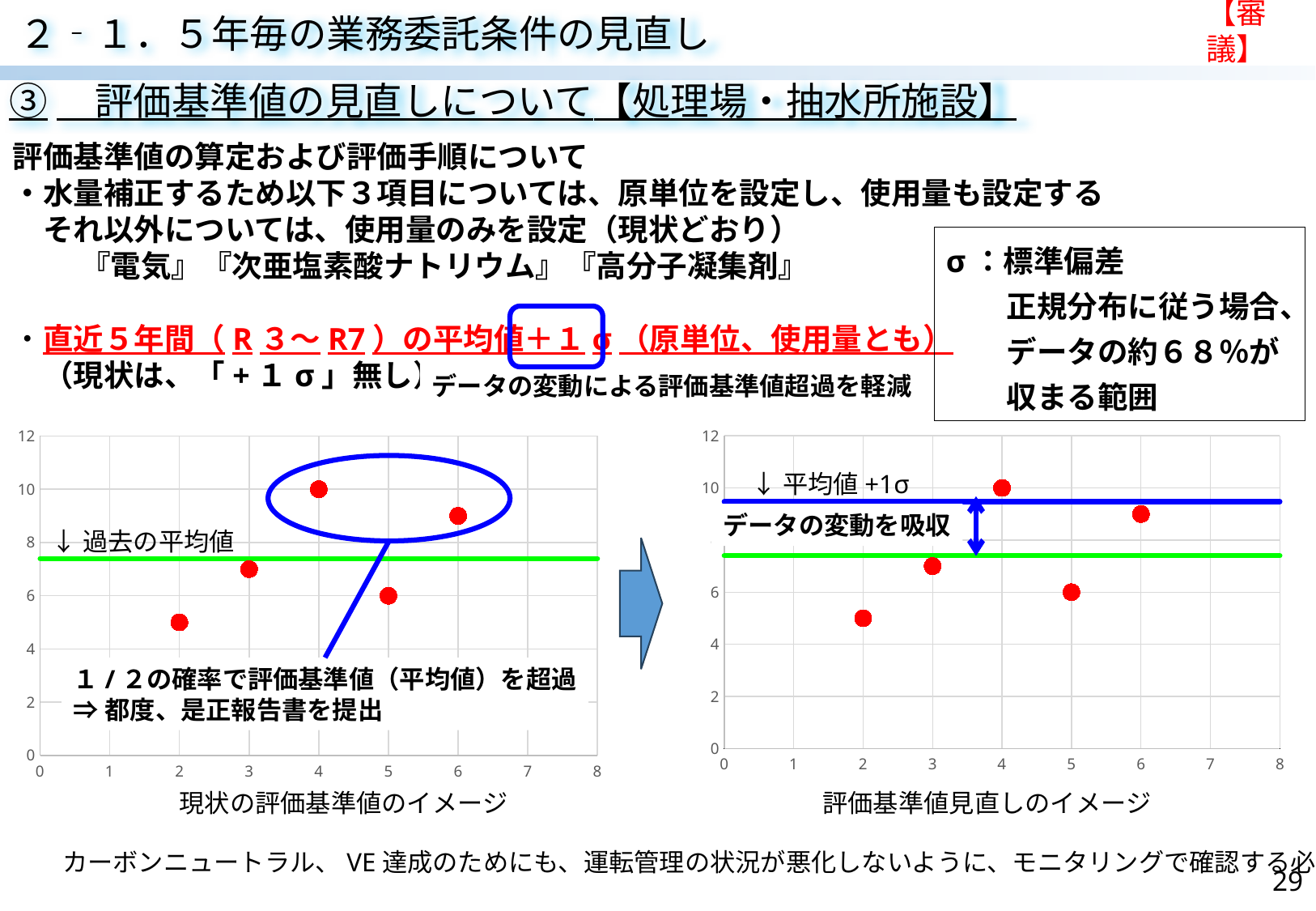
In the left chart (現状の評価基準値のイメージ), at which x value is the highest point? 4 In the left chart (現状の評価基準値のイメージ), how many data points are plotted? 5 In the left chart (現状の評価基準値のイメージ), what is the y value of the point at x = 4? 10 In the right chart (評価基準値見直しのイメージ), what does the label next to the blue horizontal line say? 平均値 +1σ In the left chart (現状の評価基準値のイメージ), is the y value of the point at x = 2 greater or less than 6? less In the left chart (現状の評価基準値のイメージ), what is the y value of the point at x = 5? 6 What kind of chart is the left chart titled 現状の評価基準値のイメージ? scatter chart In the right chart (評価基準値見直しのイメージ), how many data points are plotted? 5 In the left chart, what does the label next to the green horizontal line say? 過去の平均値 In the right chart (評価基準値見直しのイメージ), which point has the larger y value, the one at x = 4 or the one at x = 6? x = 4 In the right chart (評価基準値見直しのイメージ), is the y value of the point at x = 6 greater or less than 8? greater In the left chart (現状の評価基準値のイメージ), at which x value is the lowest point? 2